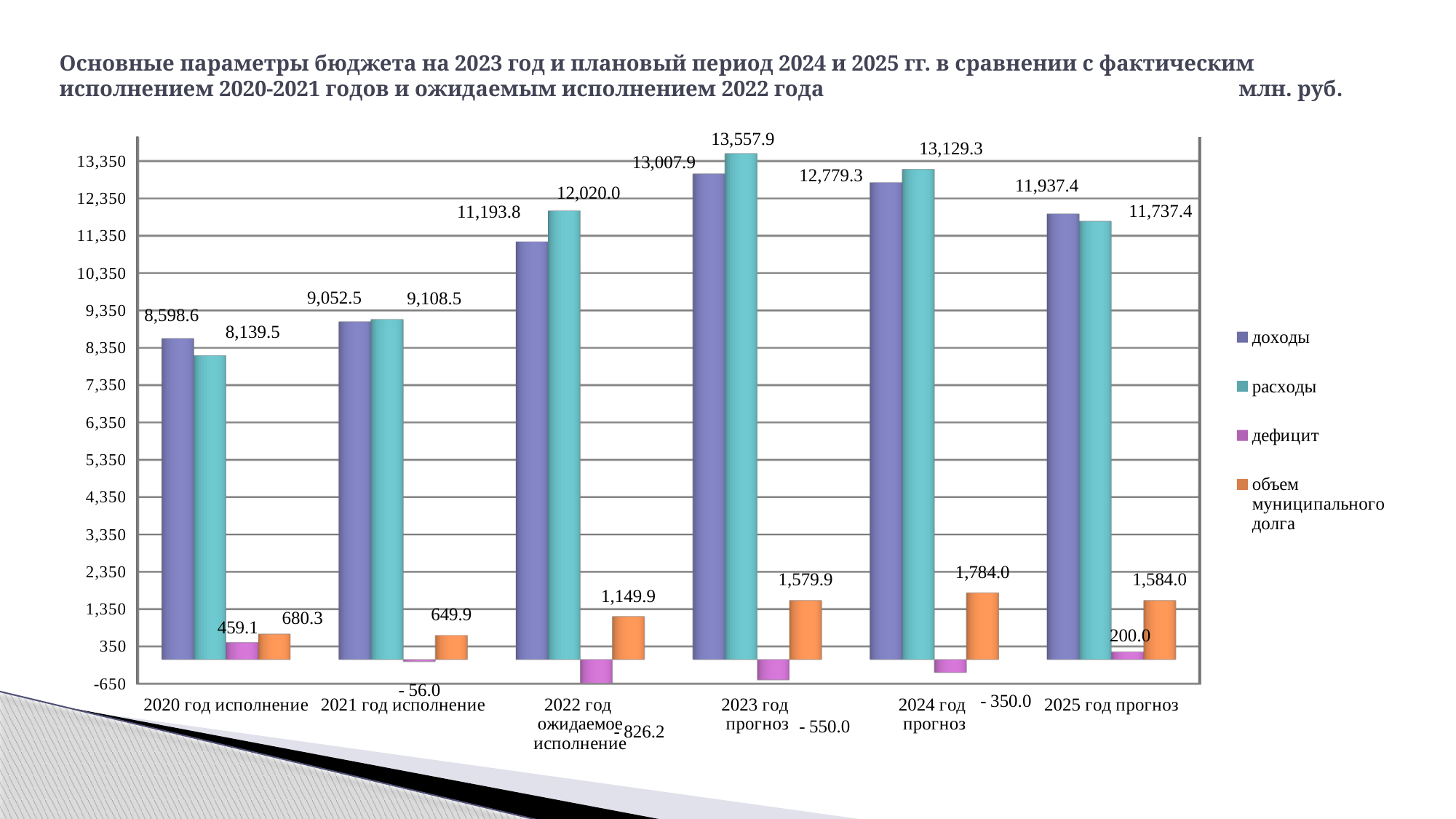
In which category is объем муниципального долга the highest? 2024 год прогноз Do the values of доходы rise or fall from 2020 год исполнение to 2023 год прогноз? rise How many categories are shown on the x axis? 6 What is the value of расходы for 2022 год ожидаемое исполнение? 12,020.0 In which category is расходы the highest? 2023 год прогноз What is the value of дефицит for 2021 год исполнение? - 56.0 What is the difference between расходы and доходы for 2023 год прогноз? 550.0 For 2025 год прогноз, which is larger: доходы or расходы? доходы How many series does the legend list? 4 What is the value of объем муниципального долга for 2024 год прогноз? 1,784.0 In which category is доходы the lowest? 2020 год исполнение What is the value of доходы for 2023 год прогноз? 13,007.9